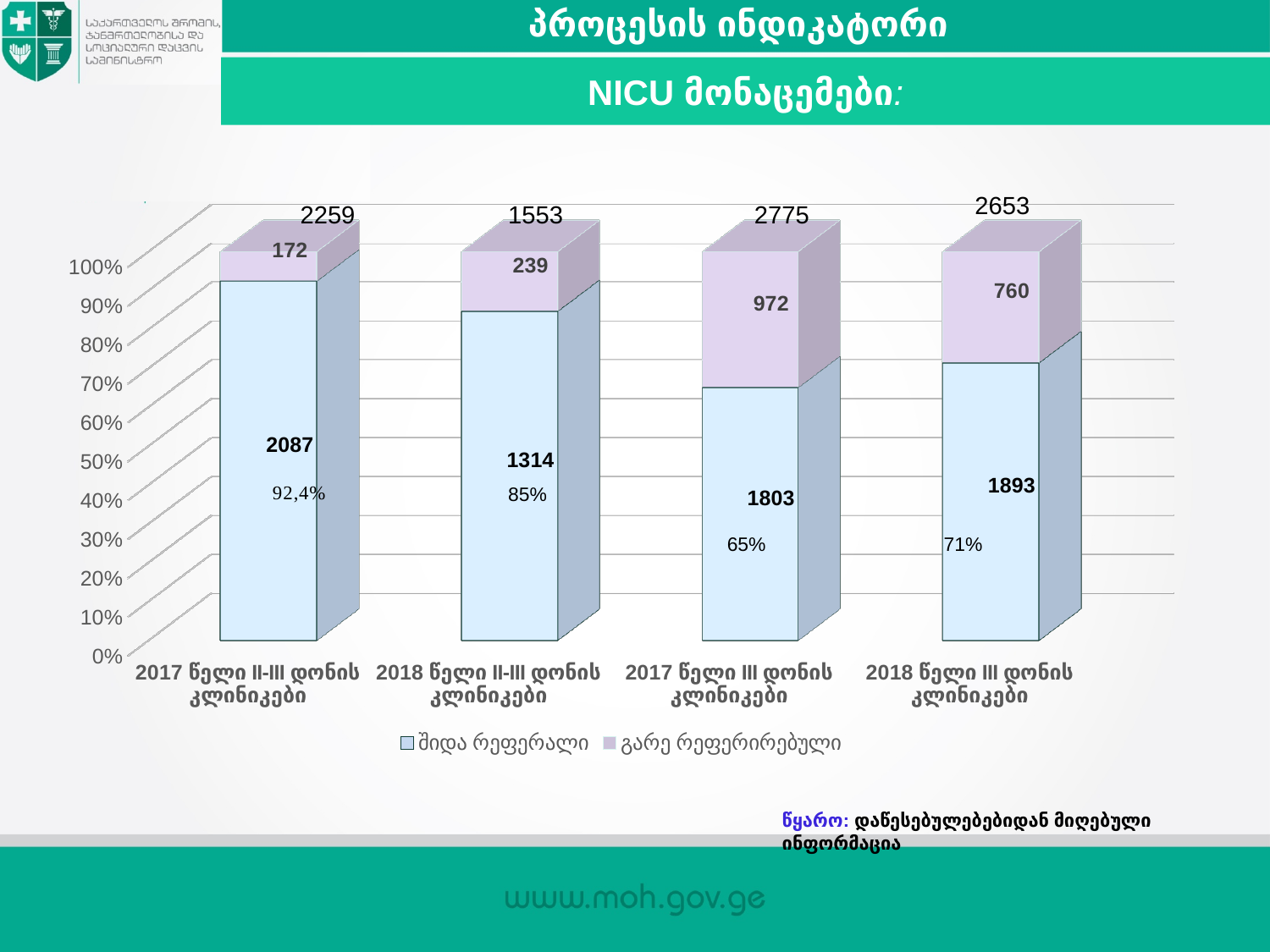
How many series does the legend list? 2 Which category has the lowest total printed above its bar? 2018 წელი II-III დონის კლინიკები Which category has the highest total printed above its bar? 2017 წელი III დონის კლინიკები What is the value of შიდა რეფერალი for 2017 წელი II-III დონის კლინიკები? 2087 What is the value of გარე რეფერირებული for 2017 წელი III დონის კლინიკები? 972 Which is larger: გარე რეფერირებული for 2017 წელი III დონის კლინიკები or for 2018 წელი III დონის კლინიკები? 2017 წელი III დონის კლინიკები How many categories are shown on the x axis? 4 What kind of chart is shown on the slide? Stacked bar chart What is the value of გარე რეფერირებული for 2018 წელი II-III დონის კლინიკები? 239 What percentage is shown for შიდა რეფერალი in 2017 წელი II-III დონის კლინიკები? 92,4% What total is printed above the bar for 2018 წელი III დონის კლინიკები? 2653 What is the difference between the შიდა რეფერალი values for 2018 წელი III დონის კლინიკები and 2017 წელი III დონის კლინიკები? 90